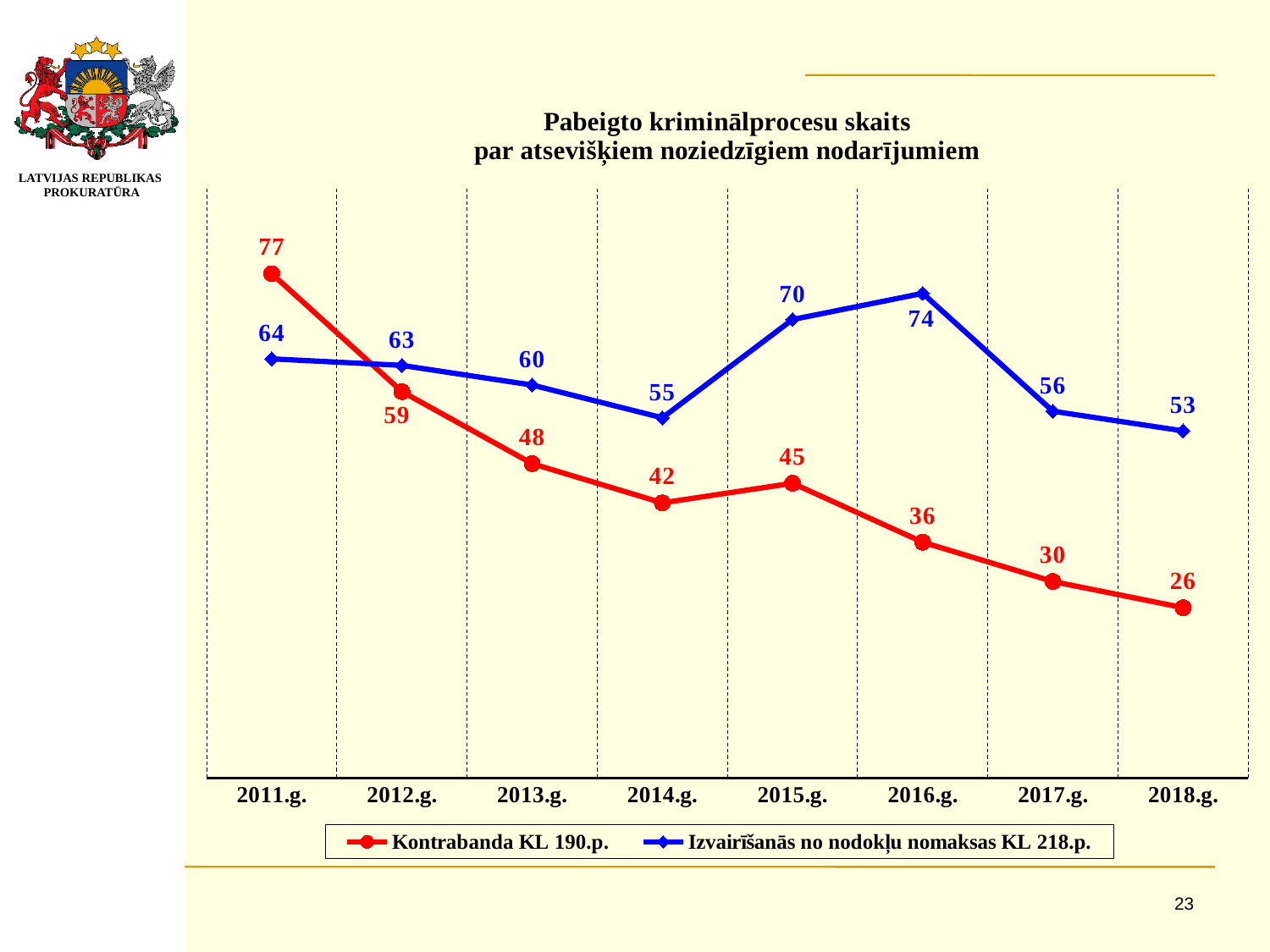
How many years are shown on the x axis? 8 What is the difference between the Izvairīšanās no nodokļu nomaksas KL 218.p. value and the Kontrabanda KL 190.p. value in 2015.g.? 25 Does the Kontrabanda KL 190.p. series generally rise or fall from 2011.g. to 2018.g.? fall In which year is the Izvairīšanās no nodokļu nomaksas KL 218.p. series highest? 2016.g. What colour is the line for Izvairīšanās no nodokļu nomaksas KL 218.p.? blue What is the value for Izvairīšanās no nodokļu nomaksas KL 218.p. in 2016.g.? 74 In which year is the Kontrabanda KL 190.p. series lowest? 2018.g. What kind of chart is shown on the slide? line chart How many series does the legend list? 2 What is the value for Kontrabanda KL 190.p. in 2018.g.? 26 What is the value for Kontrabanda KL 190.p. in 2011.g.? 77 Which series has the larger value in 2011.g., Kontrabanda KL 190.p. or Izvairīšanās no nodokļu nomaksas KL 218.p.? Kontrabanda KL 190.p.